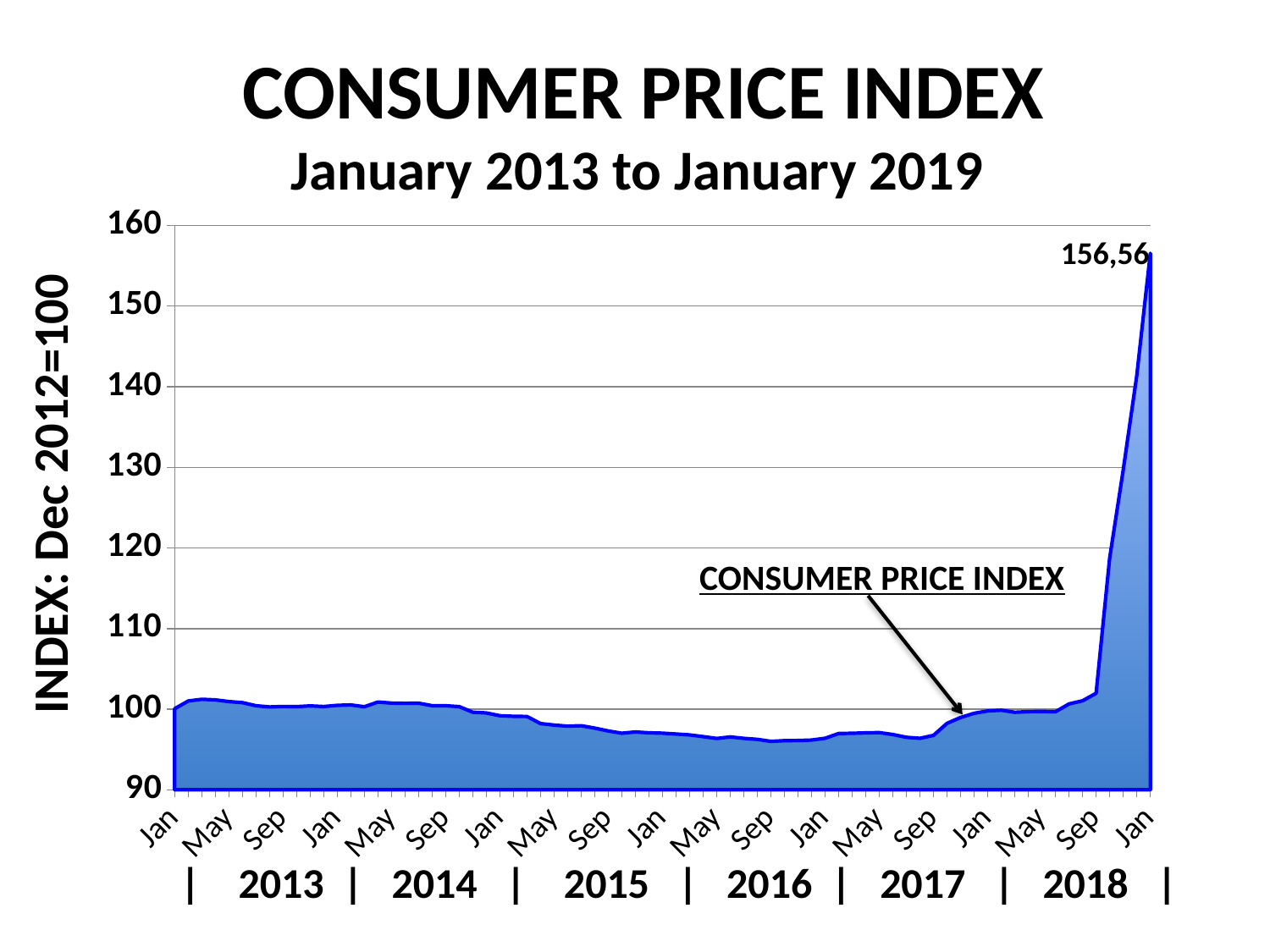
Which is larger, the value for January 2013 or the value for January 2019? January 2019 Does the Consumer Price Index rise or fall between September 2018 and January 2019? rise What is the subtitle of the chart? January 2013 to January 2019 Which is larger, the value for January 2013 or the value for September 2016? January 2013 What kind of chart is shown on the slide? area chart What is the value of the Consumer Price Index in January 2019? 156,56 How many years are labelled along the x axis? 6 Is the value for September 2016 greater or less than 100? less At which point does the Consumer Price Index reach its highest value? January 2019 What is the label of the y axis? INDEX: Dec 2012=100 Is the value for January 2019 greater or less than 150? greater Is the value for January 2017 greater or less than 100? less